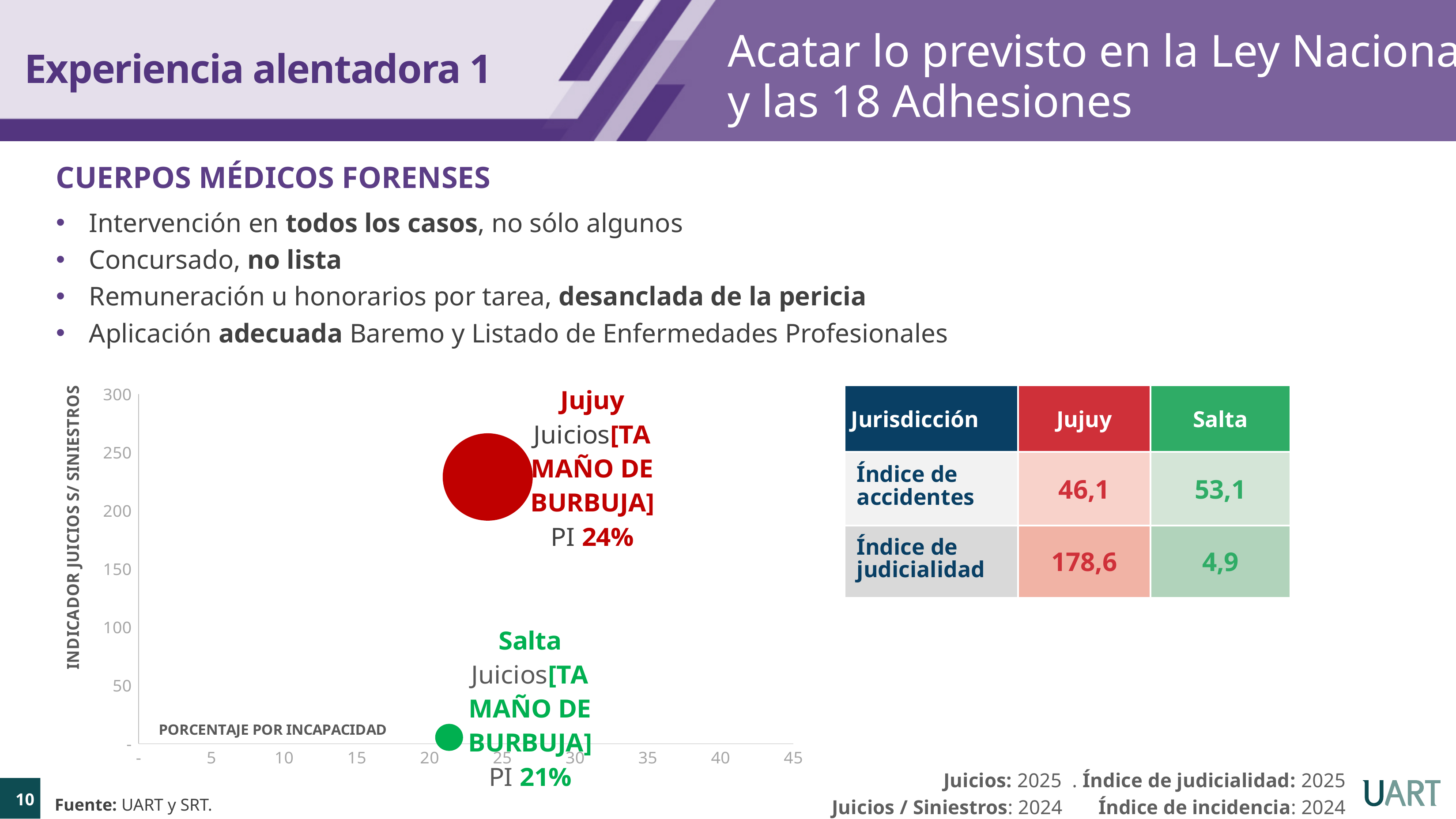
What kind of chart is shown on the slide? bubble chart Is the y-axis value (Indicador juicios s/ siniestros) for Salta greater or less than 50? less How many bubbles (jurisdictions) are plotted in the chart? 2 What is the difference between the PI values of Jujuy and Salta in the chart? 3% Which jurisdiction has the larger bubble in the chart? Jujuy Which bubble is positioned higher on the y axis (Indicador juicios s/ siniestros), Jujuy or Salta? Jujuy What is the PI value shown for Salta in the chart? 21% Is the y-axis value (Indicador juicios s/ siniestros) for Jujuy greater or less than 200? greater What is the PI value shown for Jujuy in the chart? 24% What is the title of the vertical axis of the chart? INDICADOR JUICIOS S/ SINIESTROS What is the title of the horizontal axis of the chart? PORCENTAJE POR INCAPACIDAD Which jurisdiction has the higher PI value in the chart, Jujuy or Salta? Jujuy